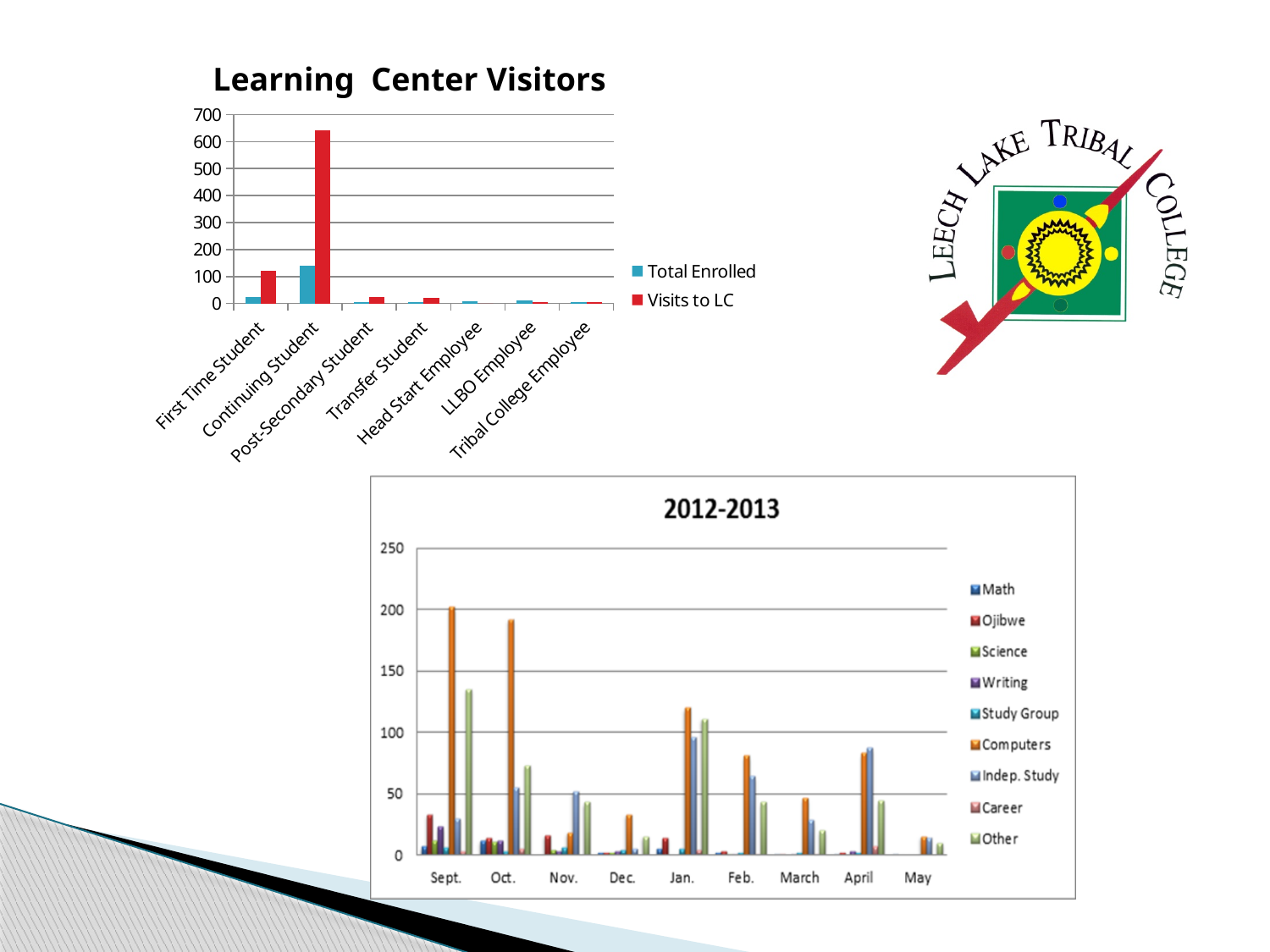
In the Learning Center Visitors chart, how many categories are shown on the x axis? 7 In the 2012-2013 chart, which is larger in Jan.: Computers or Other? Computers In the Learning Center Visitors chart, is the Visits to LC value for First Time Student greater or less than 100? greater In the 2012-2013 chart, how many series does the legend list? 9 In the 2012-2013 chart, how many months are shown on the x axis? 9 In the Learning Center Visitors chart, which category has the highest Visits to LC? Continuing Student In the Learning Center Visitors chart, which is larger for Continuing Student: Total Enrolled or Visits to LC? Visits to LC In the 2012-2013 chart, is the Computers value for Oct. greater or less than 150? greater What kind of chart is the Learning Center Visitors chart? Bar chart In the 2012-2013 chart, in which month is the Computers value highest? Sept. In the Learning Center Visitors chart, how many series does the legend list? 2 In the Learning Center Visitors chart, is the Visits to LC value for Continuing Student greater or less than 600? greater